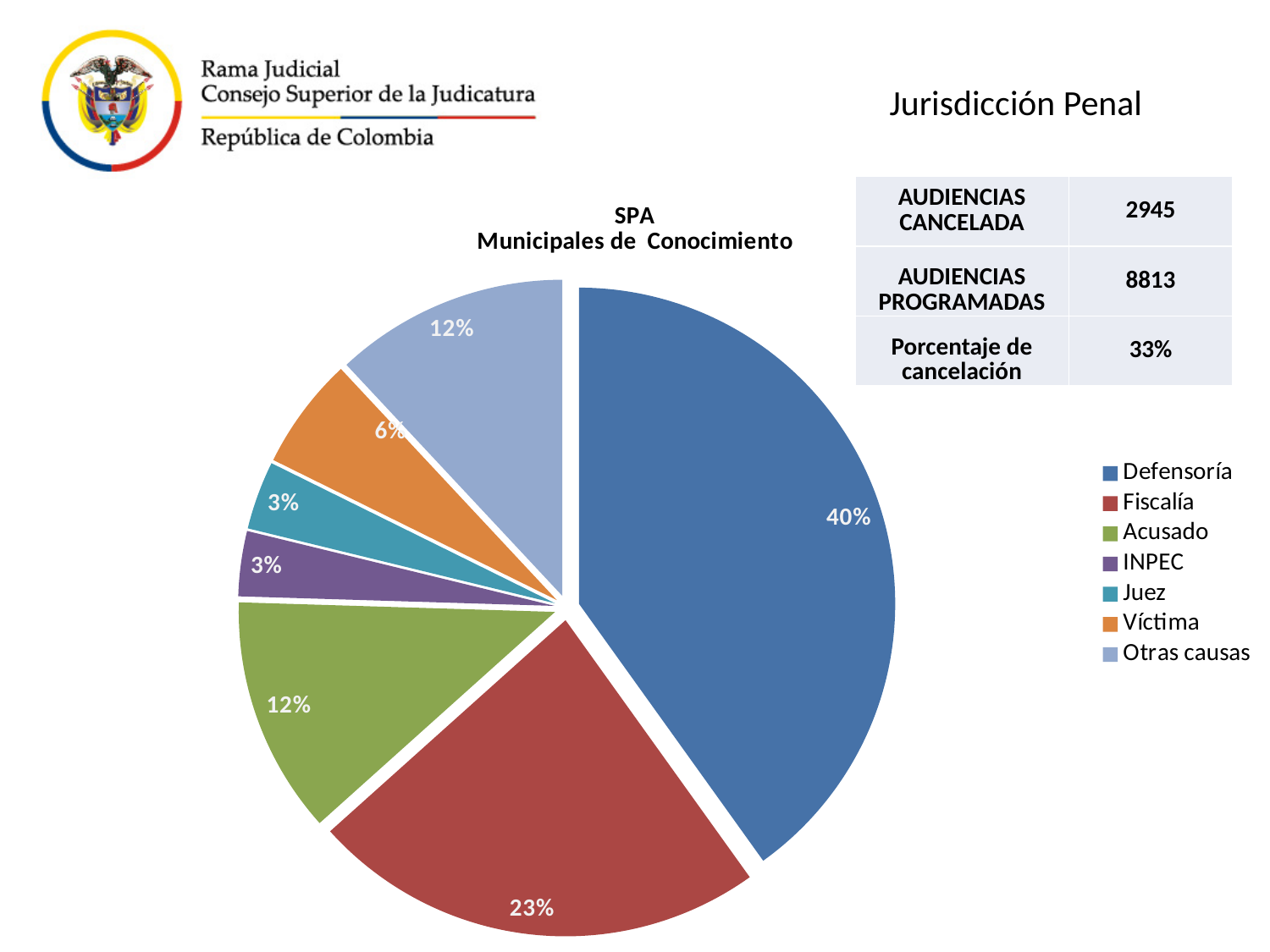
How many categories does the legend list? 7 What colour is the Otras causas slice? light blue What is the difference in percentage points between Defensoría and Fiscalía? 17 What percentage is shown for Acusado? 12% What share of the pie does Defensoría account for? 40% What percentage is shown for INPEC? 3% What type of chart is shown on the slide? pie chart Which category has the largest slice of the pie? Defensoría What percentage is shown for Víctima? 6% What is the title of the pie chart? SPA Municipales de Conocimiento What percentage is shown for Fiscalía? 23% Which is larger, the share for Víctima or the share for Juez? Víctima